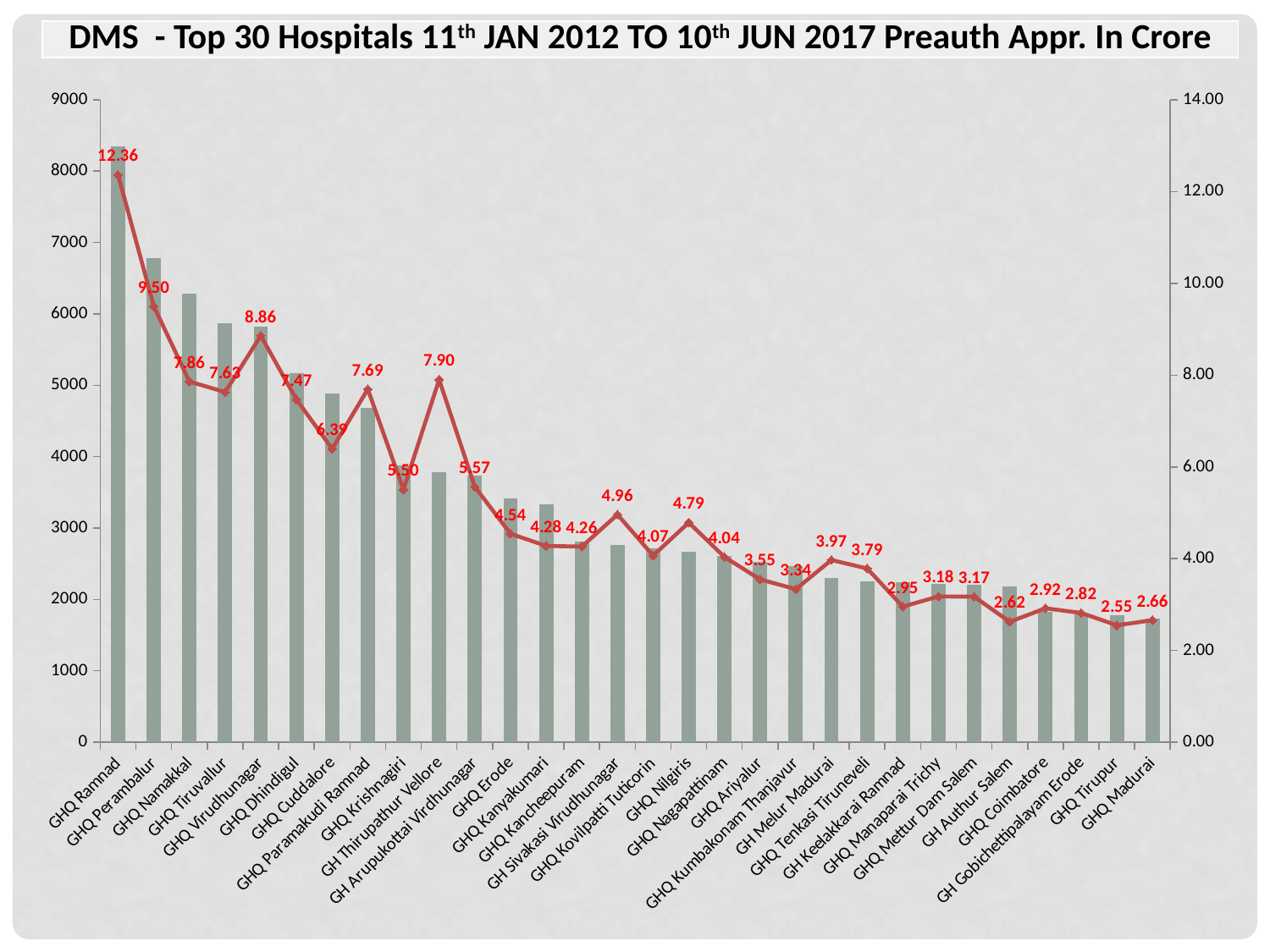
What is the preauth approval value in crore shown for GH Thirupathur Vellore? 7.90 What is the preauth approval value in crore shown for GHQ Ramnad? 12.36 Which has the larger line value in crore, GHQ Virudhunagar or GHQ Cuddalore? GHQ Virudhunagar Is the bar value for GHQ Ramnad on the left axis greater or less than 8000? greater Is the bar value for GHQ Madurai on the left axis greater or less than 2000? less How many hospitals are shown on the x axis of the chart? 30 Do the line values in crore generally rise or fall from left to right across the hospitals? Fall Which hospital has the lowest preauth approval value in crore on the line? GHQ Tirupur Which hospital has the highest preauth approval value in crore on the line? GHQ Ramnad What kind of chart is shown on the slide? Combined bar and line chart What is the difference in crore between the line values for GHQ Ramnad and GHQ Perambalur? 2.86 What is the preauth approval value in crore shown for GHQ Nilgiris? 4.79